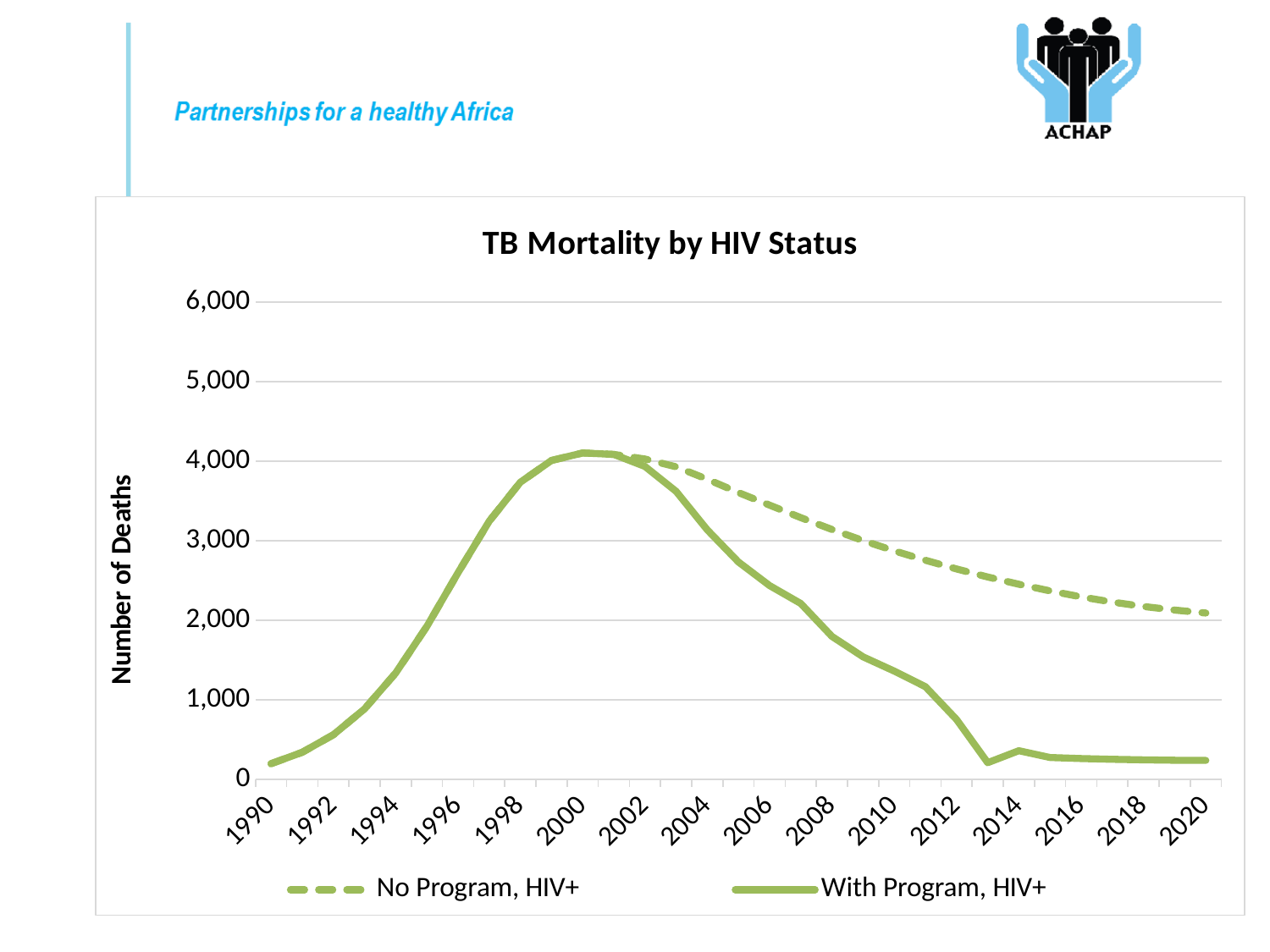
Is the value for No Program, HIV+ in 2020 greater or less than 1,000? greater Which series is drawn with a dashed line? No Program, HIV+ Does the With Program, HIV+ series rise or fall between 2002 and 2012? fall Is the peak value of the With Program, HIV+ series greater or less than 5,000? less Is the value for With Program, HIV+ in 2020 greater or less than 1,000? less Does the With Program, HIV+ series rise or fall between 1990 and 2000? rise How many series does the legend list? 2 What kind of chart is shown on the slide? line chart What is the title of the chart? TB Mortality by HIV Status In 2016, which series has the higher value: No Program, HIV+ or With Program, HIV+? No Program, HIV+